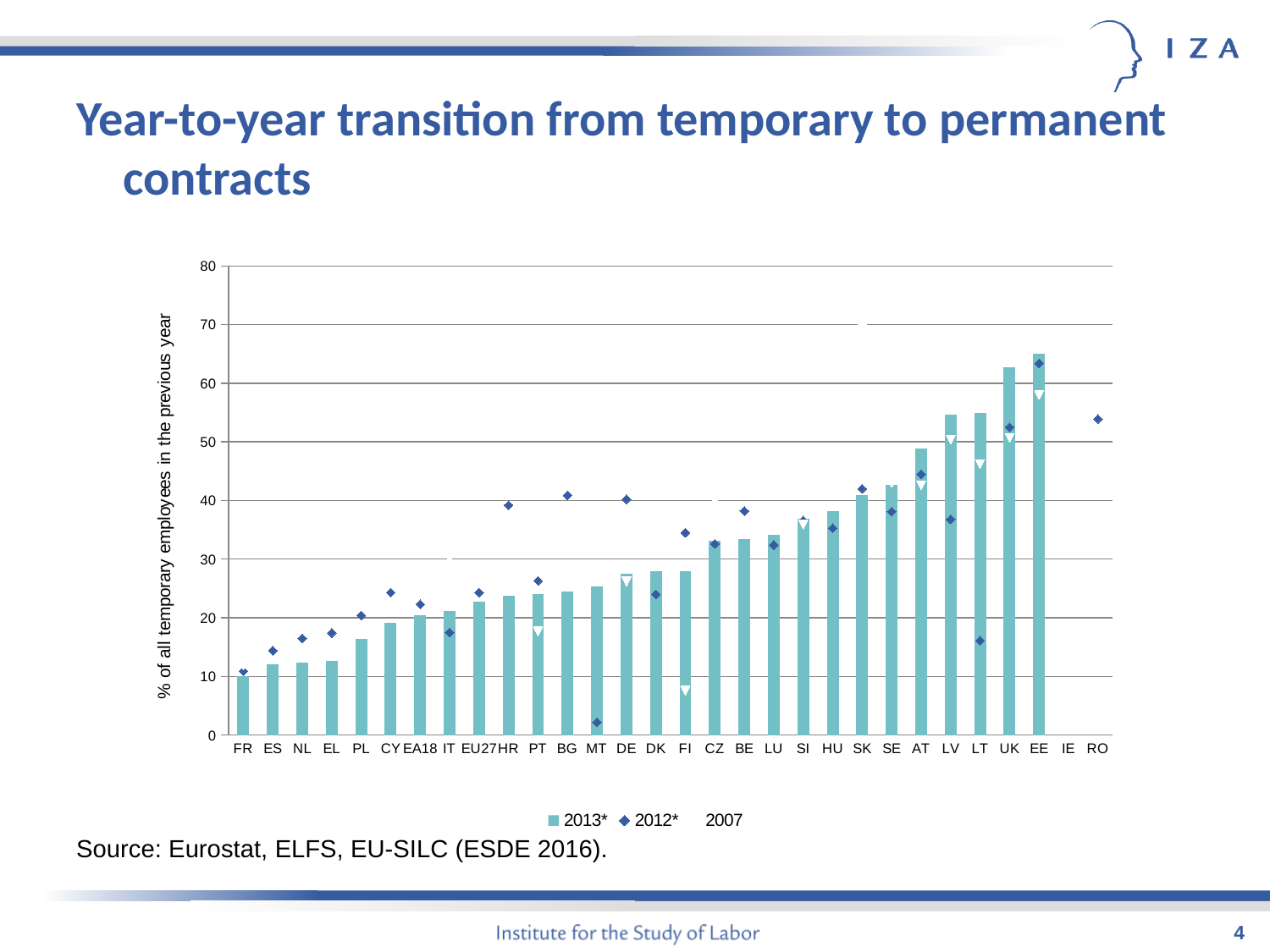
Is the 2012* value for MT greater or less than 10? less What is the label on the vertical axis? % of all temporary employees in the previous year Which category has the lowest 2013* bar? FR Is the 2013* value for HU greater or less than 40? less Which category has the highest 2013* bar? EE How many series does the legend list? 3 What kind of chart is shown on the slide? bar chart How many country/region categories are shown on the x axis? 30 Is the 2012* value for RO greater or less than 50? greater Which is larger, the 2013* bar for UK or the 2013* bar for EE? EE Do the 2013* bars generally rise or fall moving from left to right along the x axis? rise